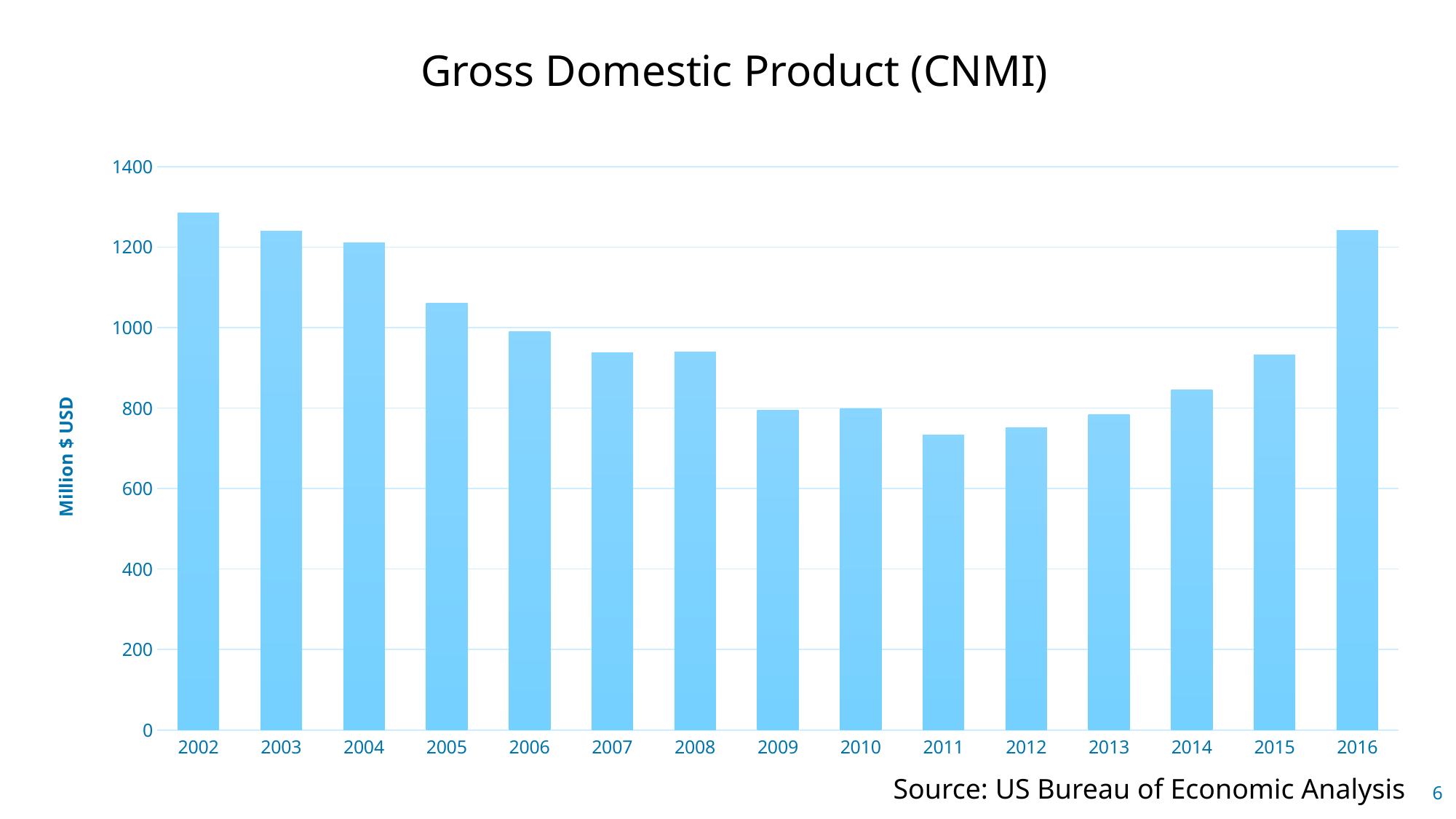
Which is larger, the value for 2005 or the value for 2014? 2005 How many years are plotted on the chart? 15 Is the value for 2011 greater or less than 800? less Which year has the lowest GDP value? 2011 Which year has the highest GDP value? 2002 What is the label on the vertical axis? Million $ USD Is the value for 2014 greater or less than 800? greater Is the value for 2005 greater or less than 1000? greater What kind of chart is shown on the slide? bar chart Do the values rise or fall from 2002 to 2011? fall Which is larger, the value for 2002 or the value for 2016? 2002